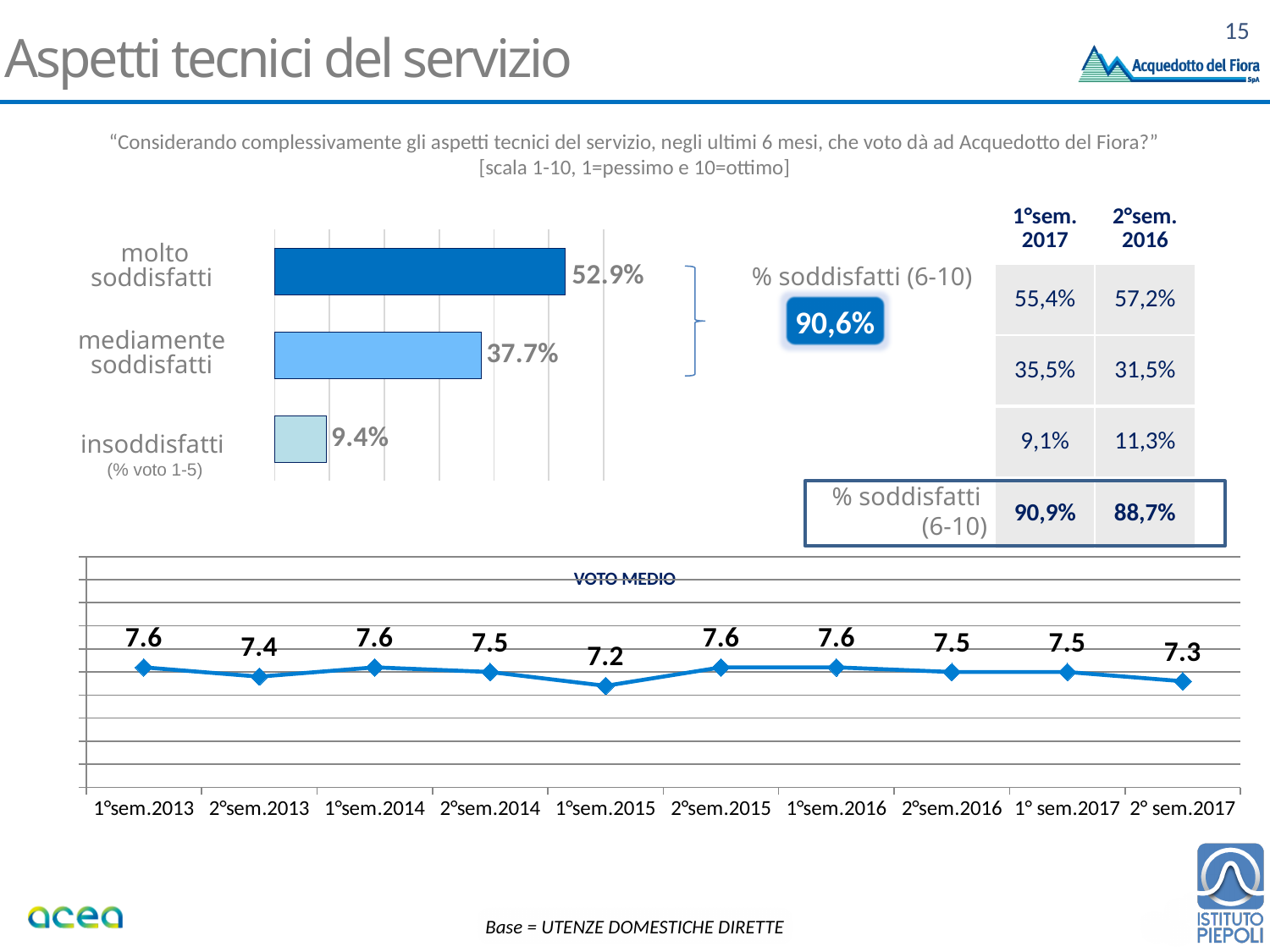
What type of chart is the chart at the top left of the slide? bar chart In the bar chart, what is the value for 'insoddisfatti'? 9.4% In the bar chart, what percentage of respondents are 'molto soddisfatti'? 52.9% In the 'VOTO MEDIO' line chart, what is the value for 1°sem.2015? 7.2 In the 'VOTO MEDIO' line chart, how many data points are plotted? 10 In the bar chart, which category has the highest value? molto soddisfatti In the 'VOTO MEDIO' line chart, does the value rise or fall from 1° sem.2017 to 2° sem.2017? fall How many categories does the bar chart show? 3 In the bar chart, what is the value for 'mediamente soddisfatti'? 37.7% In the 'VOTO MEDIO' line chart, which period has the lowest value? 1°sem.2015 In the bar chart, which category has the lowest value? insoddisfatti In the bar chart, what is the difference between 'molto soddisfatti' and 'mediamente soddisfatti'? 15.2 percentage points